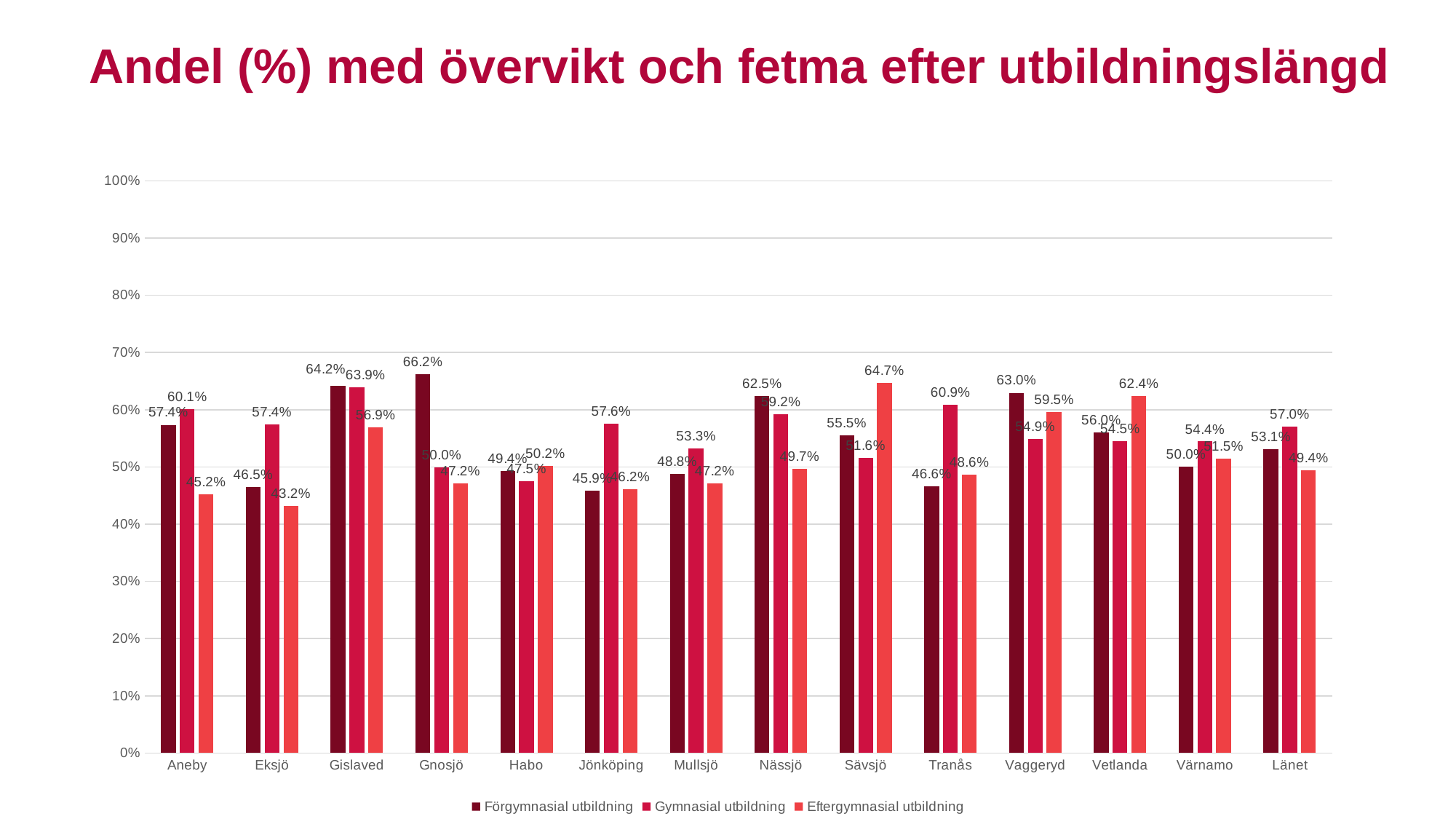
What kind of chart is shown on the slide? Bar chart Is the Eftergymnasial utbildning value for Vetlanda greater or less than 60%? greater What is the difference between the Förgymnasial utbildning and Eftergymnasial utbildning values for Gnosjö? 19.0 percentage points What is the value for Sävsjö in the Eftergymnasial utbildning series? 64.7% Which category has the highest value in the Förgymnasial utbildning series? Gnosjö Which category has the highest value in the Gymnasial utbildning series? Gislaved What is the value for Länet in the Gymnasial utbildning series? 57.0% What is the value for Gnosjö in the Förgymnasial utbildning series? 66.2% How many categories are shown on the x axis? 14 Which is larger for Tranås: the Gymnasial utbildning value or the Förgymnasial utbildning value? Gymnasial utbildning Which category has the lowest value in the Eftergymnasial utbildning series? Eksjö How many series does the legend list? 3